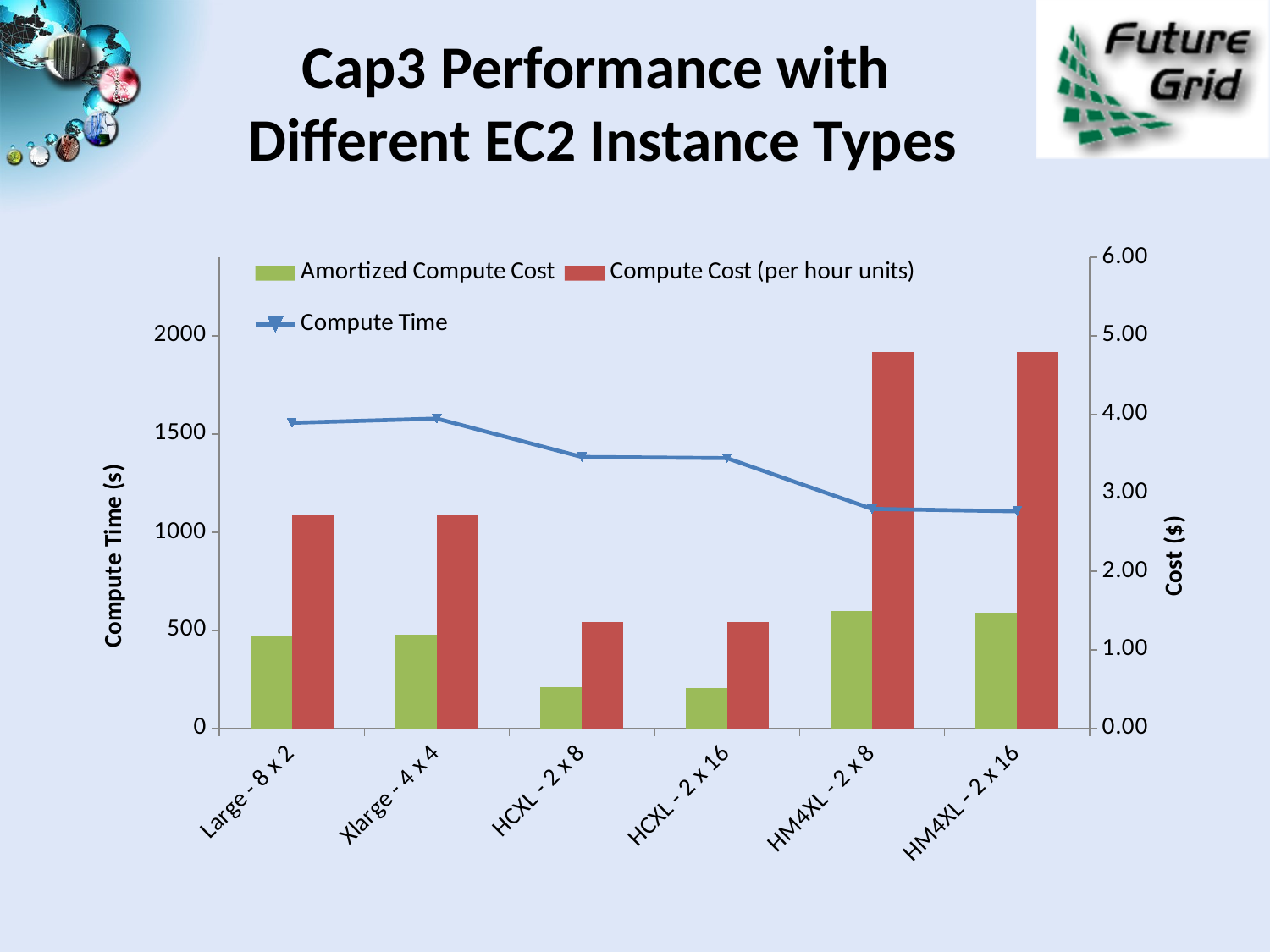
Is the Compute Cost (per hour units) for HCXL - 2 x 8 greater or less than 2.00? less What is the title of the right-hand vertical axis? Cost ($) Is the Compute Time for HM4XL - 2 x 16 greater or less than 1500? less Is the Compute Cost (per hour units) for HM4XL - 2 x 8 greater or less than 4.00? greater How many EC2 instance type categories are shown on the x axis of the chart? 6 What kind of chart is used to show the Amortized Compute Cost and Compute Cost (per hour units) series? Bar chart Does the Compute Time line rise or fall from Large - 8 x 2 to HM4XL - 2 x 16? Fall Which has the higher Compute Cost (per hour units): HM4XL - 2 x 8 or HCXL - 2 x 8? HM4XL - 2 x 8 Which has the higher Compute Time: Large - 8 x 2 or HM4XL - 2 x 8? Large - 8 x 2 How many series does the chart legend list? 3